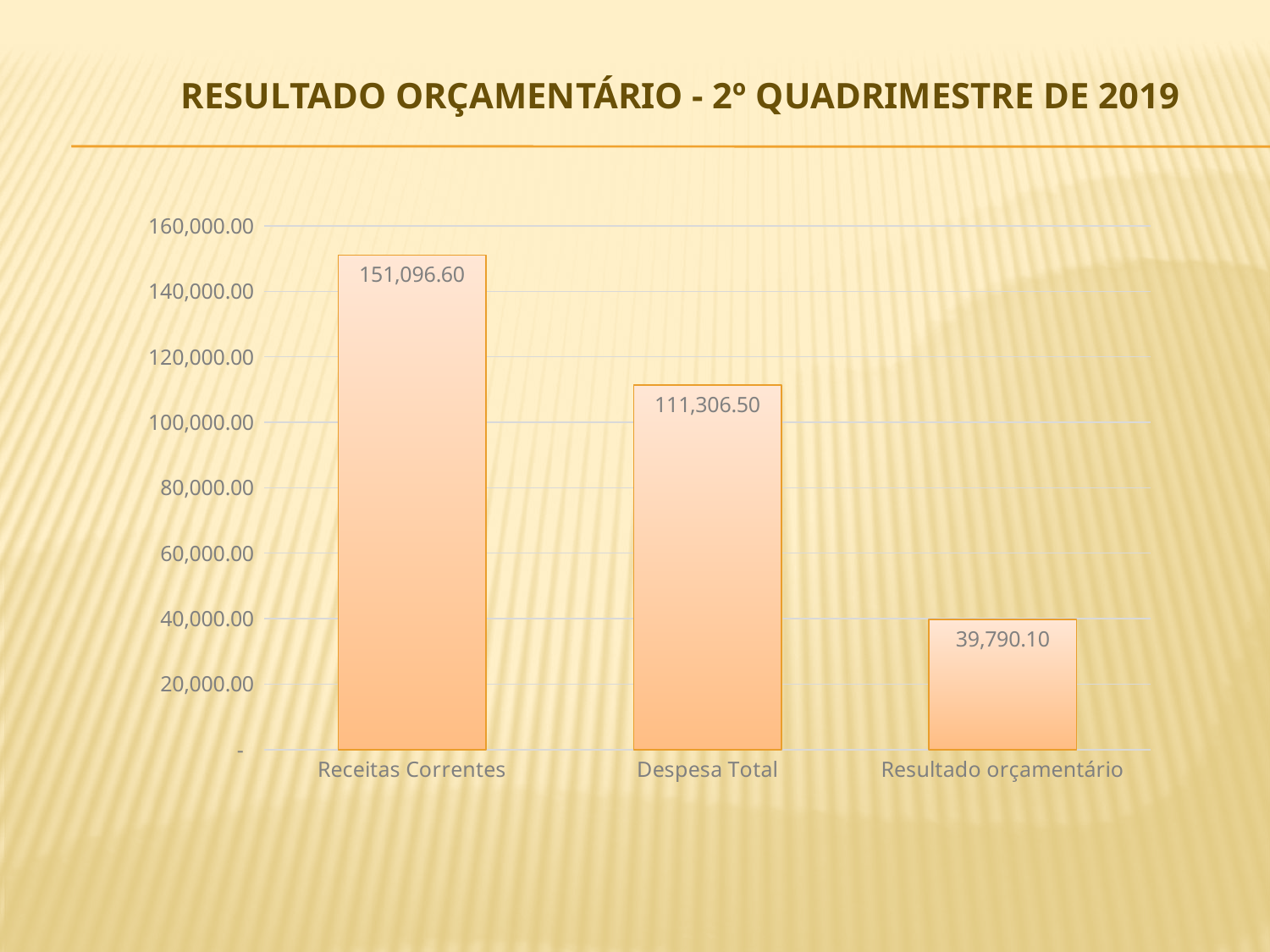
Which category has the lowest value? Resultado orçamentário Which category has the highest value? Receitas Correntes What is the difference between Receitas Correntes and Despesa Total? 39,790.10 How many categories are shown in the chart? 3 What is the title of the slide? RESULTADO ORÇAMENTÁRIO - 2º QUADRIMESTRE DE 2019 Is the value for Despesa Total greater or less than 100,000.00? greater Which is larger, Despesa Total or Resultado orçamentário? Despesa Total What is the value for Despesa Total? 111,306.50 What is the value for Resultado orçamentário? 39,790.10 What is the value for Receitas Correntes? 151,096.60 What kind of chart is shown on the slide? bar chart What is the difference between Despesa Total and Resultado orçamentário? 71,516.40